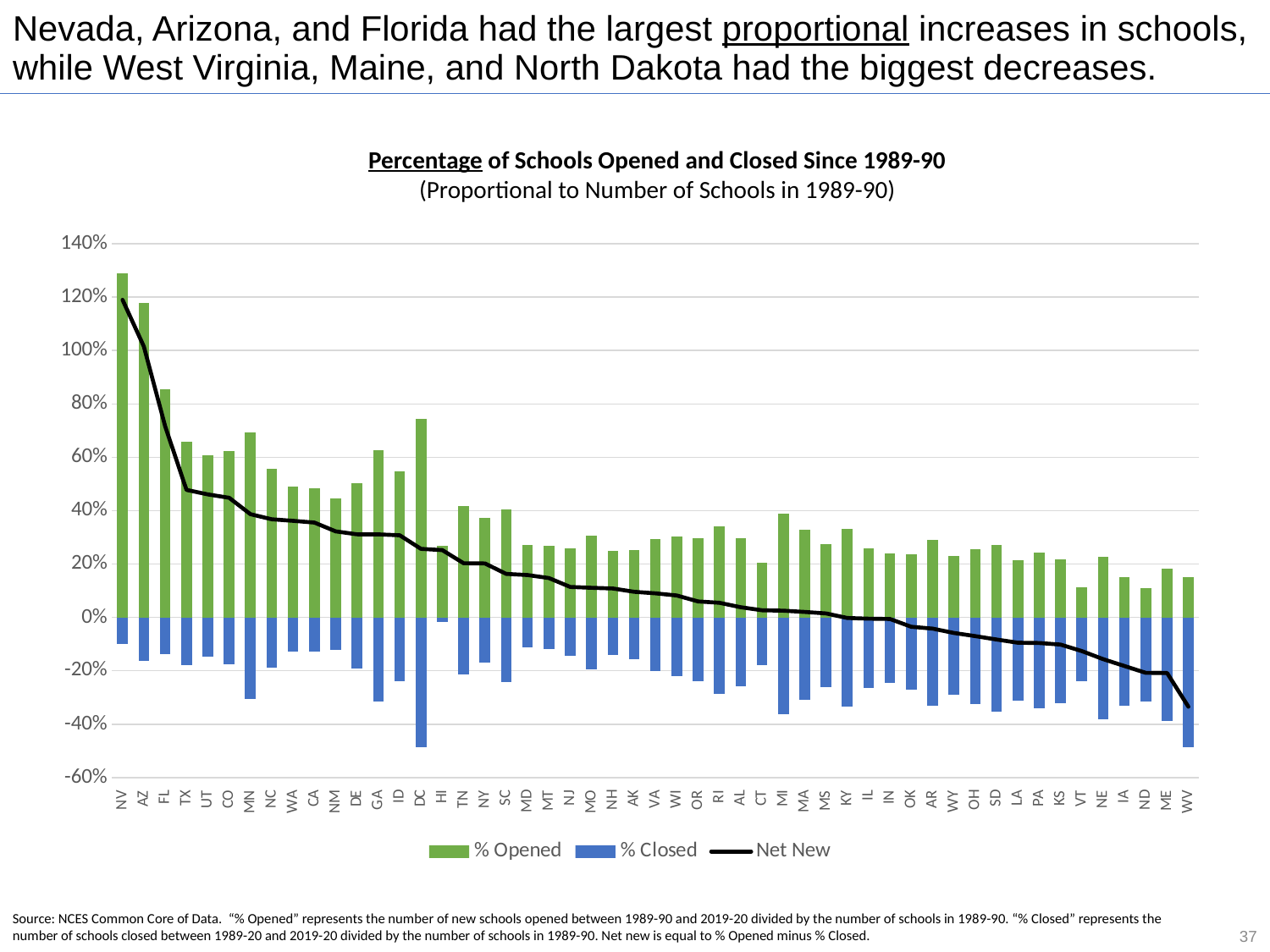
Is the Net New value for WV greater or less than -20%? less Which state has the highest % Opened value? NV How many series does the legend list? 3 How many states/jurisdictions are shown along the x axis? 51 Which has the larger % Opened value, NV or AZ? NV Is the % Closed value for DC greater or less than -40%? less Is the % Opened value for FL greater or less than 80%? greater Which state has the lowest Net New value? WV Does the Net New line generally rise or fall from left to right across the x axis? fall What kind of chart is shown on the slide? bar chart with a line